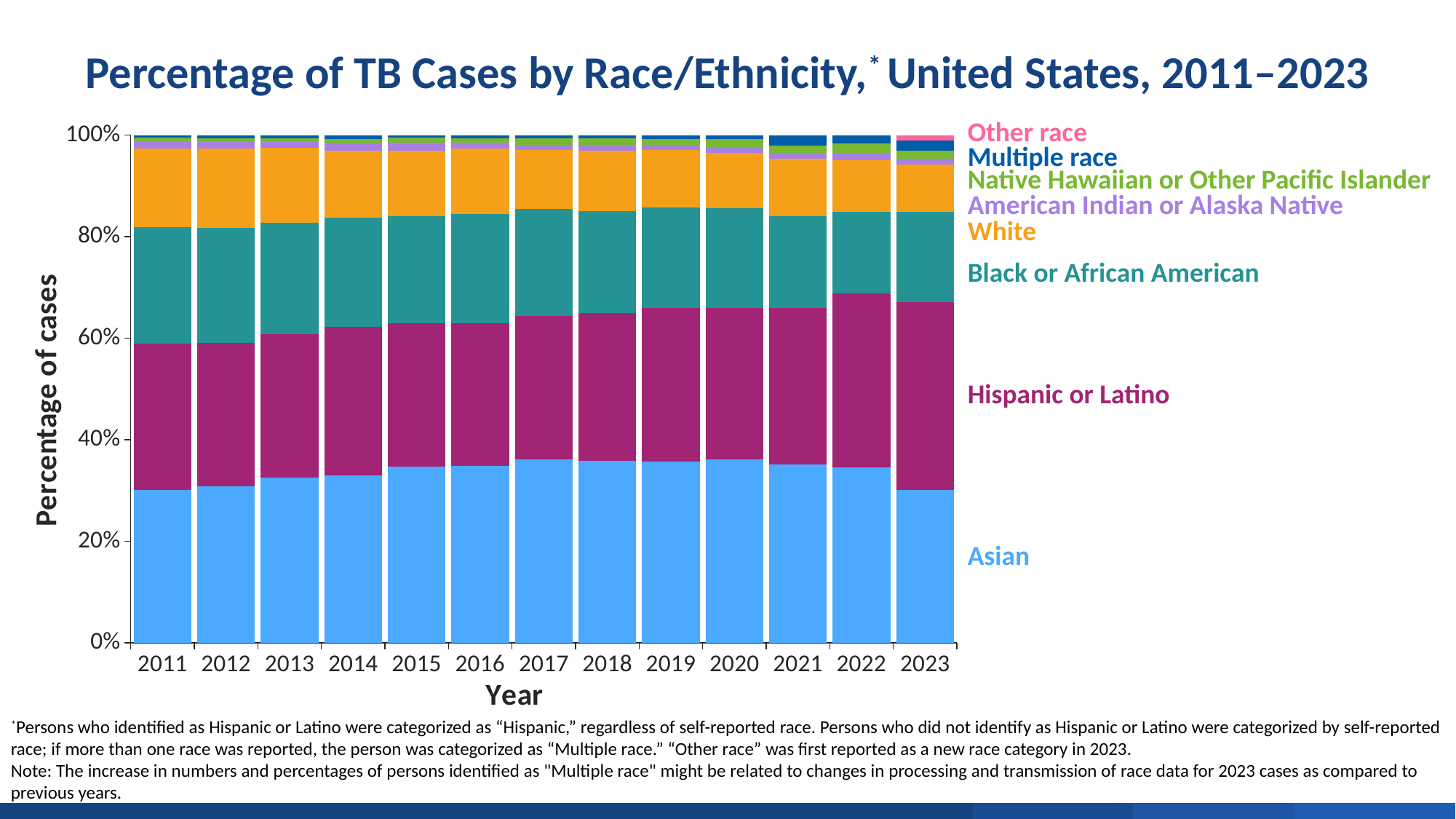
Is the Asian share of TB cases in 2017 greater or less than 20%? greater In 2023, does the top of the Hispanic or Latino segment sit above or below the 60% line? above Is the Asian share of TB cases larger in 2017 or in 2023? 2017 Which category appears at the bottom of each stacked bar? Asian Is the Hispanic or Latino share of TB cases larger in 2011 or in 2023? 2023 How many years are shown along the x axis of the chart? 13 Does the Asian share of TB cases rise or fall from 2011 to 2017? rise Which race/ethnicity category has the largest share of TB cases in 2023? Hispanic or Latino How many race/ethnicity categories does the legend list? 8 In 2011, is the cumulative share of Asian, Hispanic or Latino, and Black or African American cases greater or less than 90%? less What kind of chart is shown on the slide? Stacked bar chart